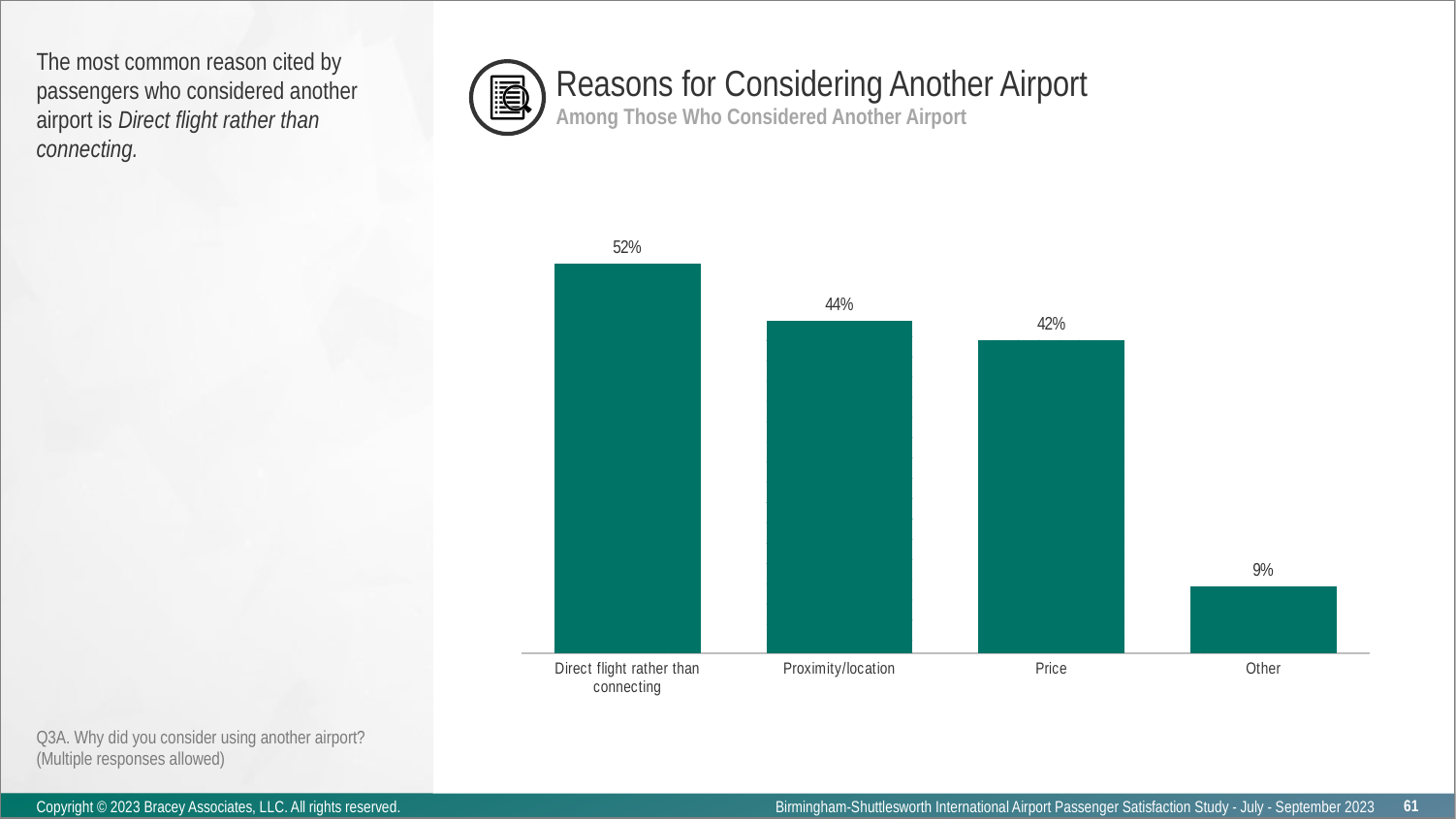
What percentage of passengers cited 'Direct flight rather than connecting' as a reason for considering another airport? 52% What type of chart is used on this slide? Bar chart What is the value shown for 'Proximity/location'? 44% Which reason has the lowest percentage? Other What is the value shown for 'Other'? 9% Which is larger, the value for 'Direct flight rather than connecting' or the value for 'Price'? Direct flight rather than connecting What is the value shown for 'Price'? 42% How many reasons (categories) are shown in the chart? 4 What is the difference in percentage points between 'Proximity/location' and 'Price'? 2 percentage points What is the title of the chart? Reasons for Considering Another Airport What is the difference in percentage points between 'Direct flight rather than connecting' and 'Other'? 43 percentage points Which reason has the highest percentage? Direct flight rather than connecting